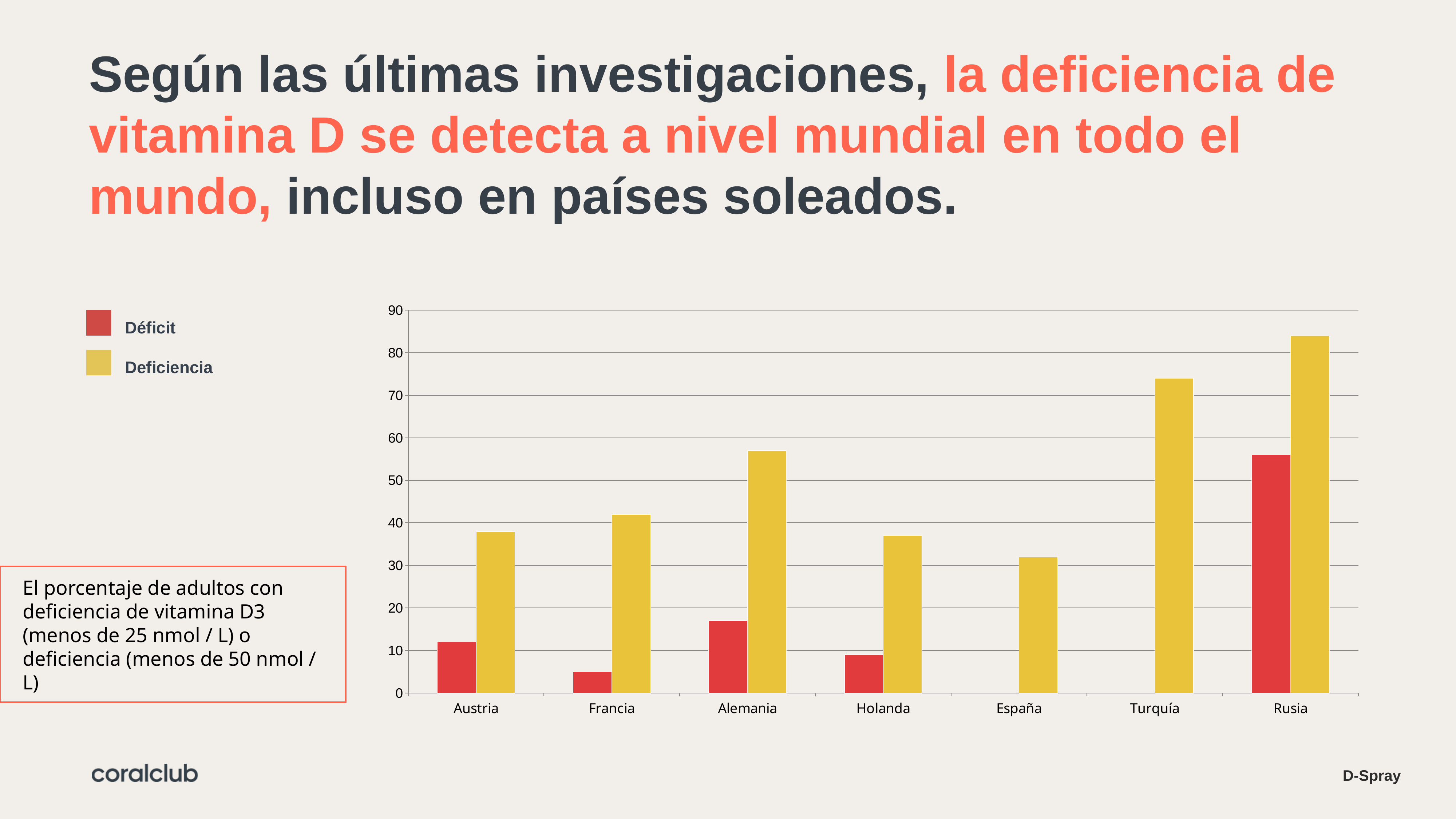
What colour represents the Déficit series in the chart? red Is the Deficiencia value for Alemania greater or less than 50? greater Which country has the lowest Deficiencia value? España How many countries are shown on the x axis of the chart? 7 Which is larger, the Déficit value for Alemania or the Déficit value for Holanda? Alemania How many series does the legend list? 2 Is the Déficit value for Francia greater or less than 10? less Is the Deficiencia value for Turquía greater or less than 70? greater What kind of chart is shown on the slide? bar chart Which country has the highest Deficiencia value? Rusia Which is larger, the Deficiencia value for Austria or the Deficiencia value for Turquía? Turquía Which country has the highest Déficit value? Rusia